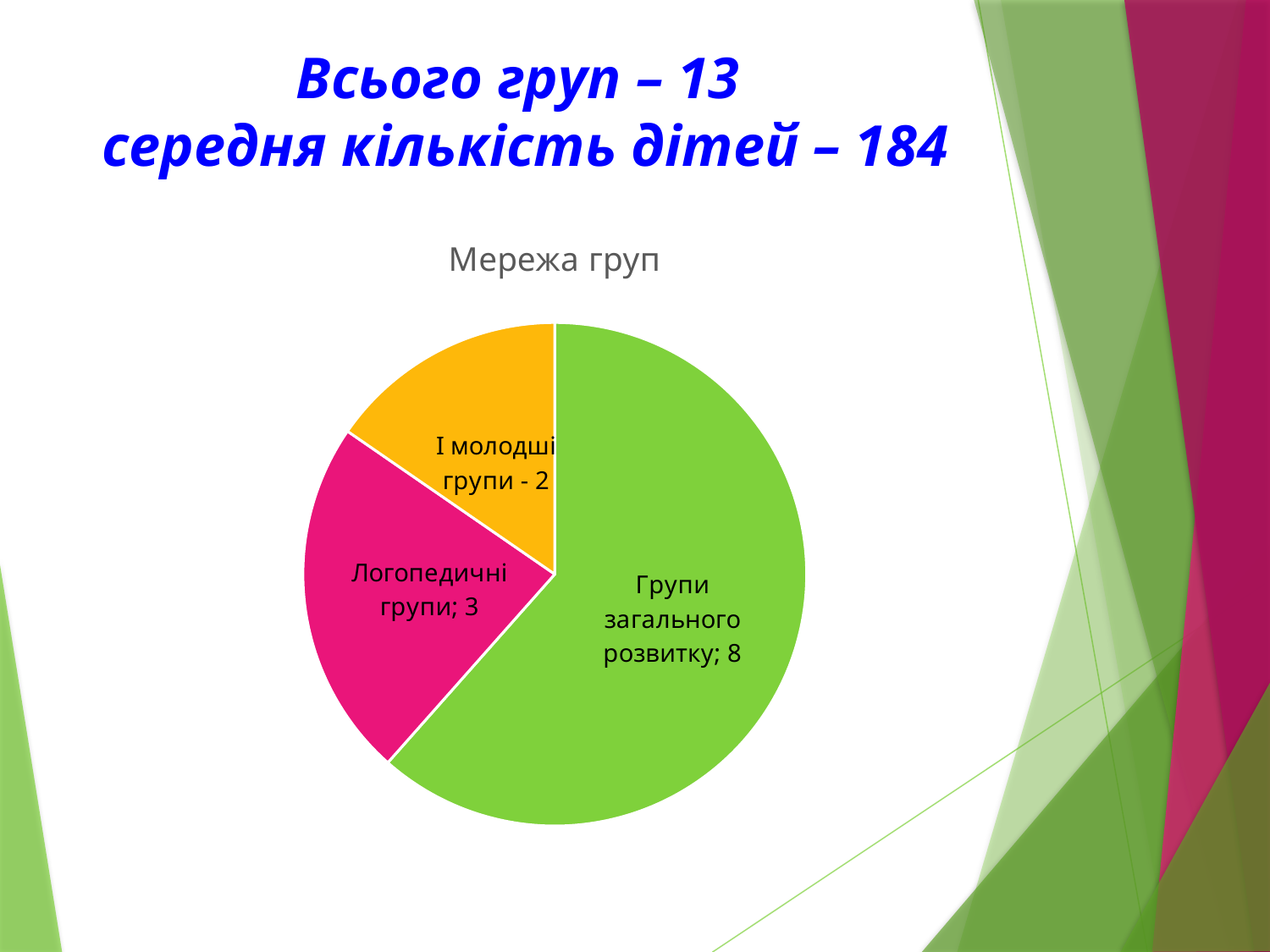
Which category has the smallest slice of the pie? І молодші групи Which category has the largest slice of the pie? Групи загального розвитку What is the value for Логопедичні групи? 3 What is the value for Групи загального розвитку? 8 What is the difference between the values for Групи загального розвитку and Логопедичні групи? 5 Which is larger: the value for Логопедичні групи or the value for І молодші групи? Логопедичні групи What type of chart is shown on the slide? pie chart What colour is the slice for Логопедичні групи? pink (magenta) What is the value for І молодші групи? 2 What is the total of all slices in the pie chart? 13 How many slices does the pie chart have? 3 What is the title of the chart? Мережа груп